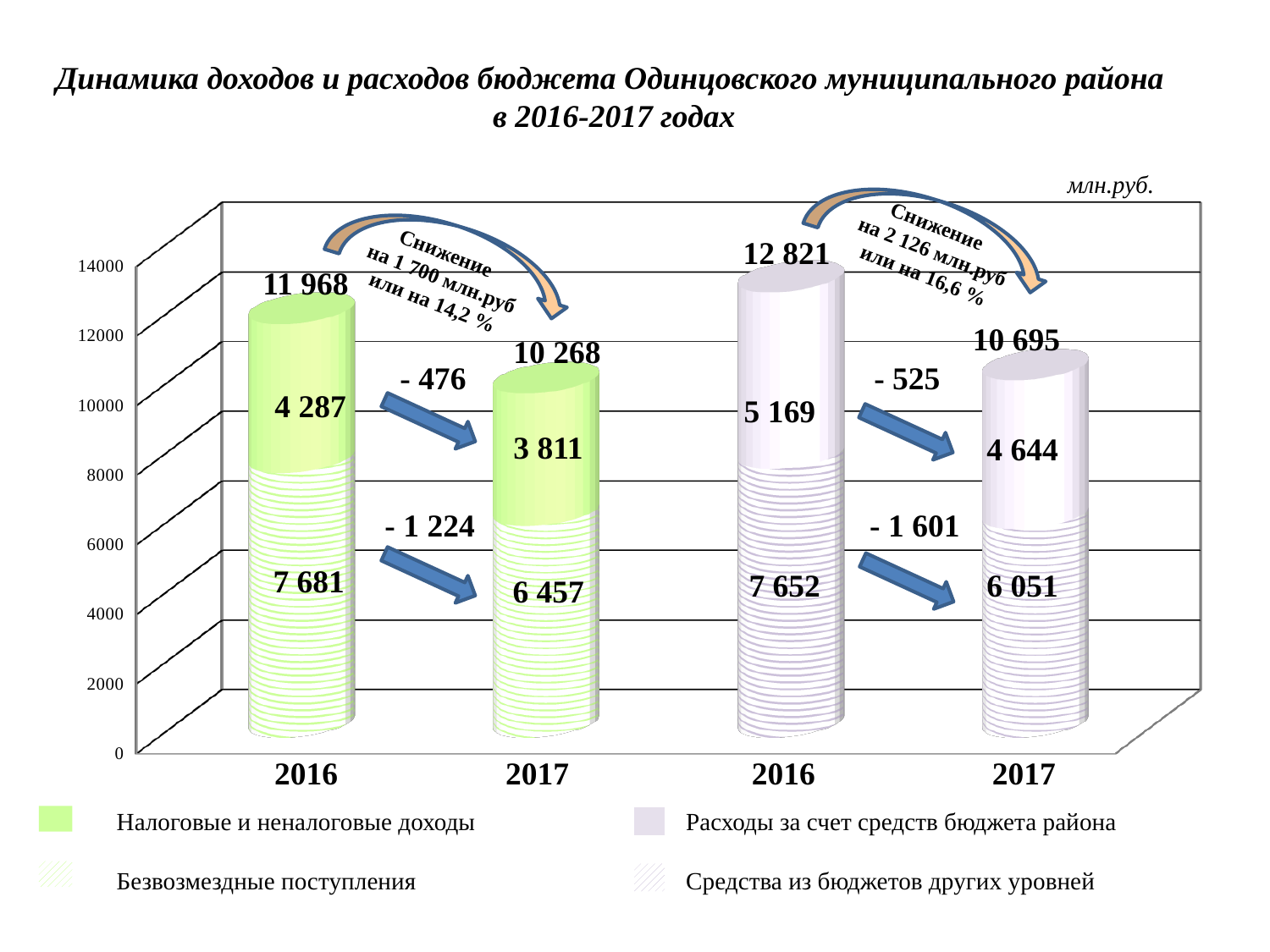
How many entries does the legend list? 4 What is the total value printed above the rightmost (grey) 2017 bar? 10 695 What is the value of 'Средства из бюджетов других уровней' in the grey 2016 bar? 7 652 What kind of chart is shown on the slide? A stacked bar chart How many bars are plotted on the chart? 4 What is the value of 'Налоговые и неналоговые доходы' in the green 2017 bar? 3 811 Which is larger: 'Расходы за счет средств бюджета района' in the grey 2016 bar or in the grey 2017 bar? The grey 2016 bar (5 169) Which of the four bars has the lowest total? The green 2017 bar (10 268) What is the total value printed above the leftmost (green) 2016 bar? 11 968 What is the difference between the totals of the green 2016 bar (11 968) and the green 2017 bar (10 268)? 1 700 What is the value of 'Безвозмездные поступления' in the green 2016 bar? 7 681 Which of the four bars has the highest total? The grey 2016 bar (12 821)